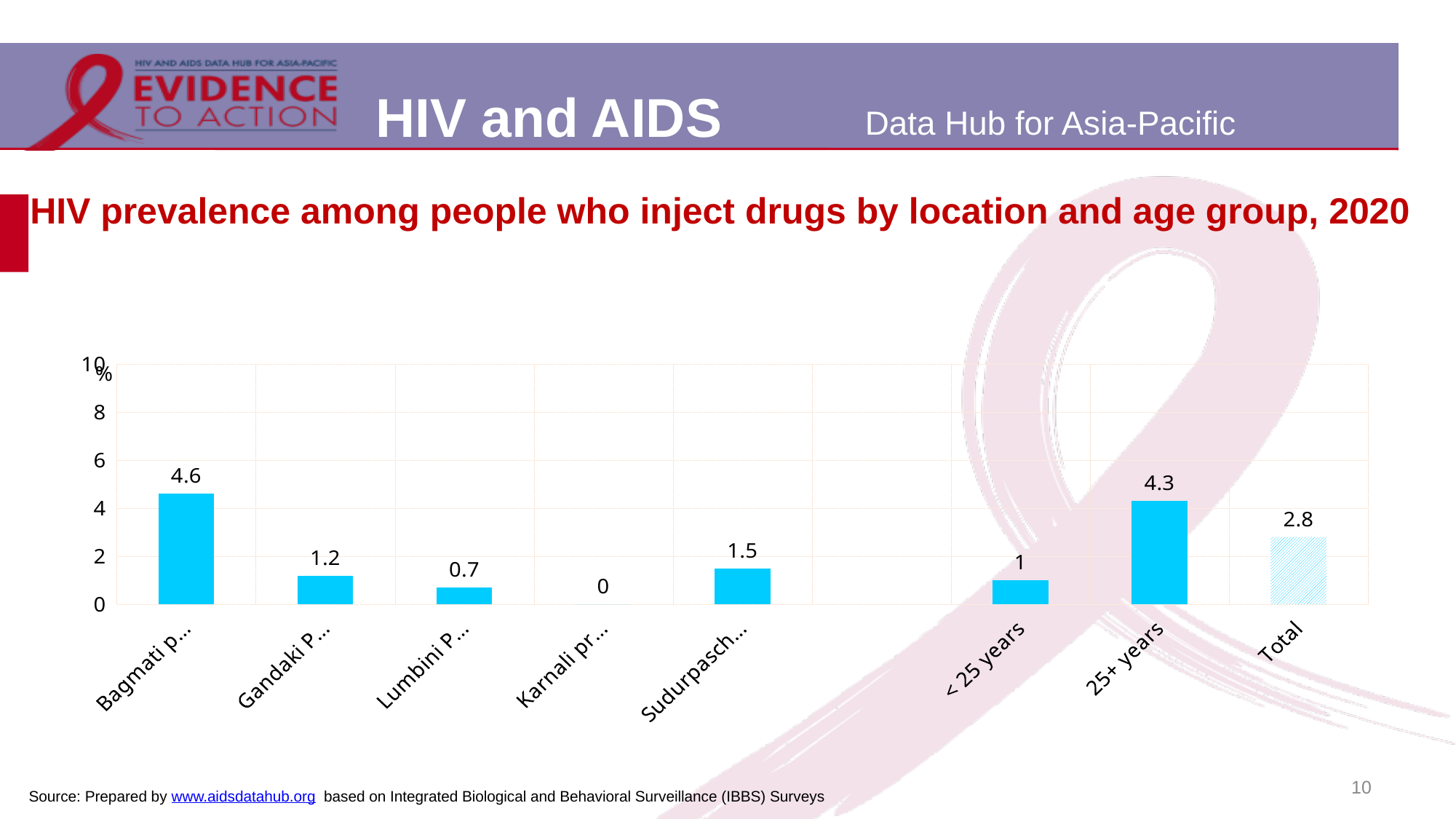
What is the value shown for the Total bar? 2.8 What is the difference between the value for Bagmati province and the Total? 1.8 What is the title of the chart on the slide? HIV prevalence among people who inject drugs by location and age group, 2020 What value is shown for the 25+ years age group? 4.3 Which category has the lowest value in the chart? Karnali province What is the HIV prevalence value shown for Bagmati province? 4.6 What kind of chart is shown on the slide? Bar chart Which category has the highest value in the chart? Bagmati province What is the difference between the values for 25+ years and < 25 years? 3.3 Which has a higher value, Gandaki province or Sudurpaschim province? Sudurpaschim province What value is shown for Lumbini province? 0.7 What value is shown for Karnali province? 0